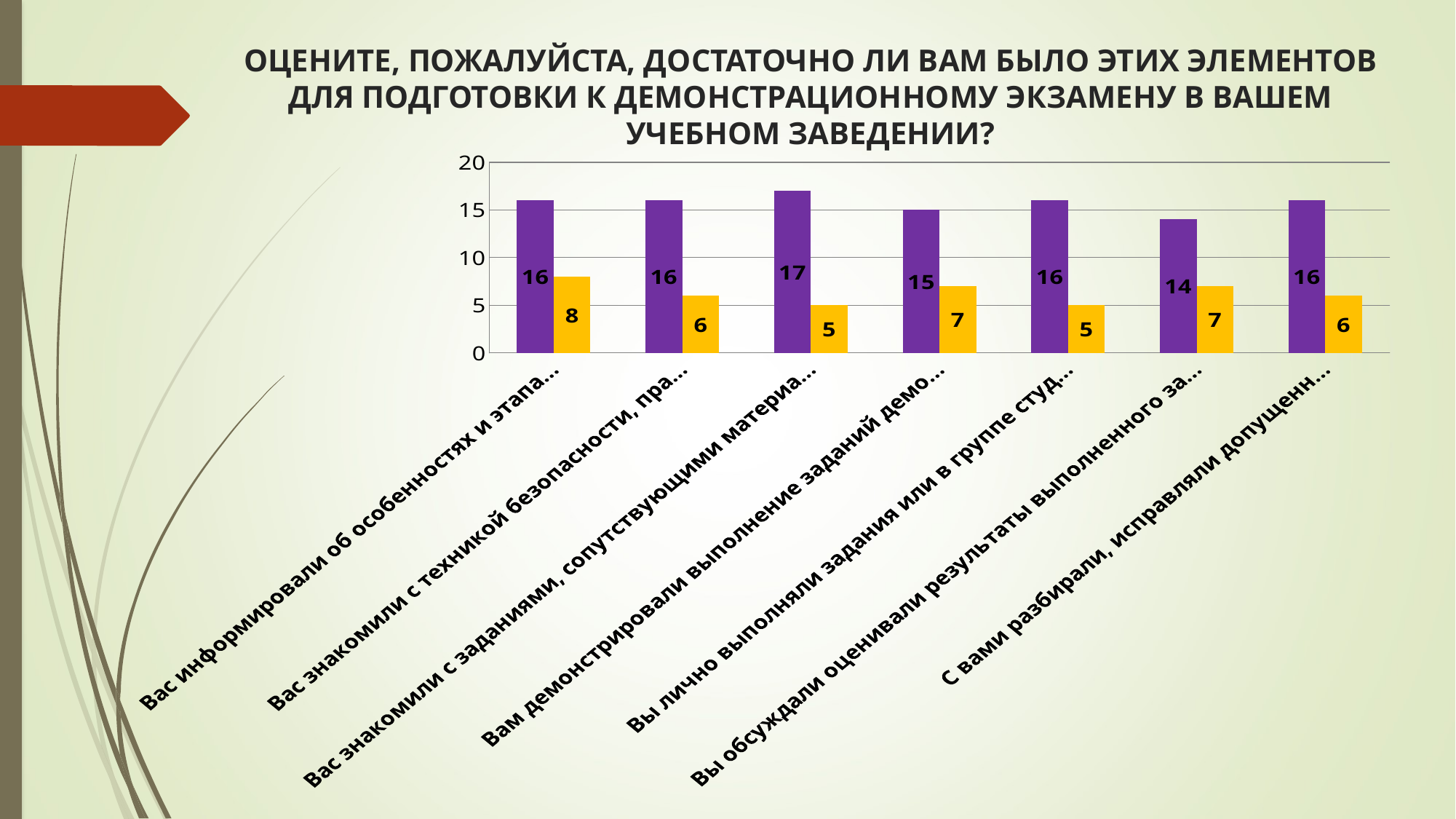
What is the value of the yellow bar for the category "Вас информировали об особенностях и этапа…"? 8 What is the difference between the purple and yellow bars for the category "Вам демонстрировали выполнение заданий демо…"? 8 Which category has the highest purple bar? Вас знакомили с заданиями, сопутствующими материа… Which is larger for the category "Вы лично выполняли задания или в группе студ…": the purple bar or the yellow bar? the purple bar What is the value of the purple bar for the category "Вас знакомили с заданиями, сопутствующими материа…"? 17 What is the highest value shown on the vertical axis of the chart? 20 What kind of chart is shown on the slide? bar chart Which category has the lowest purple bar? Вы обсуждали оценивали результаты выполненного за… Which category has the highest yellow bar? Вас информировали об особенностях и этапа… What is the value of the yellow bar for the category "С вами разбирали, исправляли допущенн…"? 6 What is the value of the purple bar for the category "Вы обсуждали оценивали результаты выполненного за…"? 14 How many categories are shown on the x axis of the chart? 7